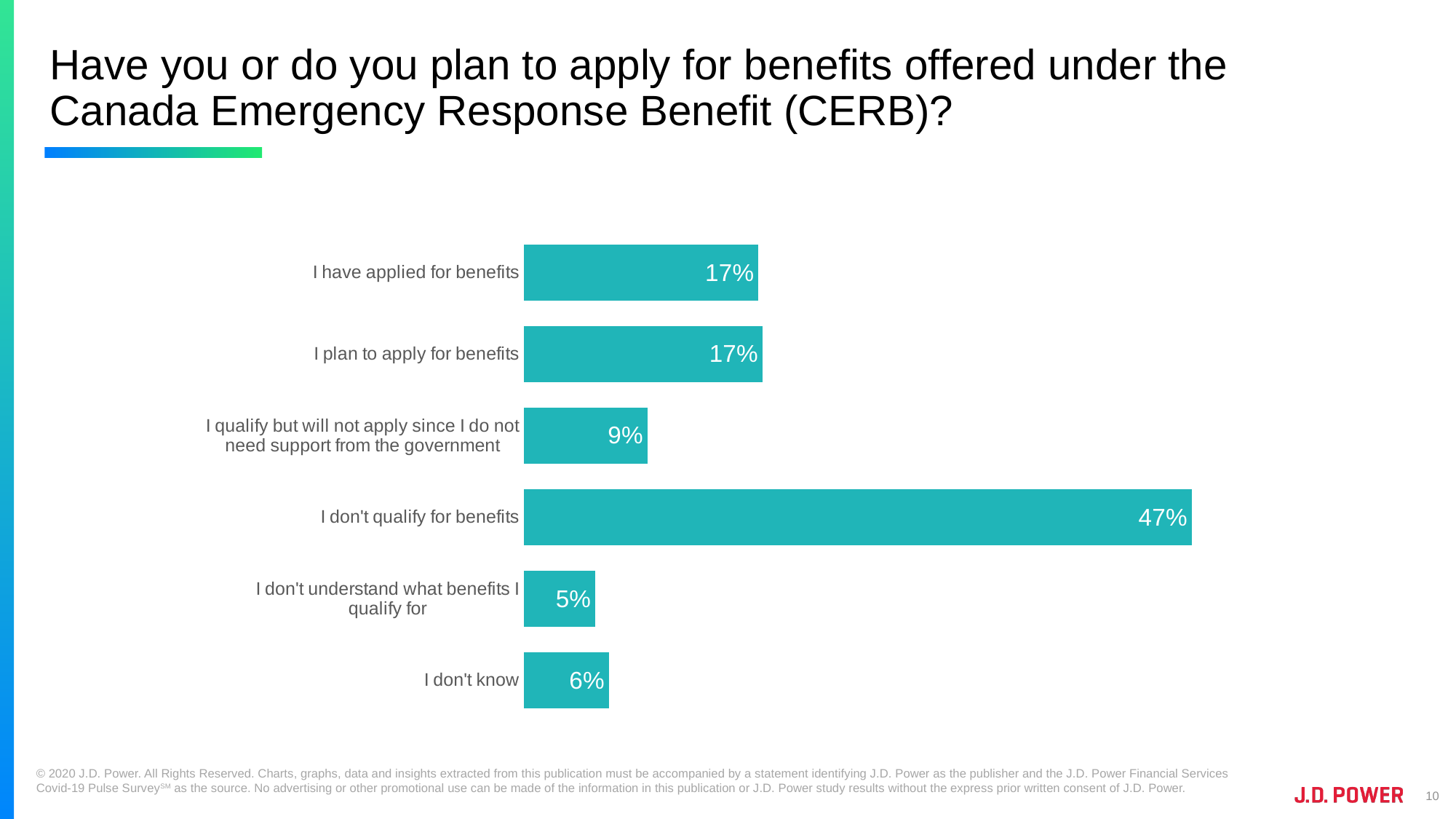
Which response has the lowest percentage? I don't understand what benefits I qualify for What type of chart is shown on the slide? Bar chart What is the combined percentage of respondents who have applied or plan to apply for benefits? 34% What percentage of respondents said "I qualify but will not apply since I do not need support from the government"? 9% Which response has the highest percentage? I don't qualify for benefits How many response categories are shown in the chart? 6 Which is larger: the value for "I don't know" or the value for "I don't understand what benefits I qualify for"? I don't know What percentage of respondents said "I don't know"? 6% What percentage of respondents said "I have applied for benefits"? 17% What percentage of respondents said "I don't qualify for benefits"? 47% What is the difference in percentage points between "I don't qualify for benefits" and "I plan to apply for benefits"? 30 percentage points What colour are the bars in the chart? Teal